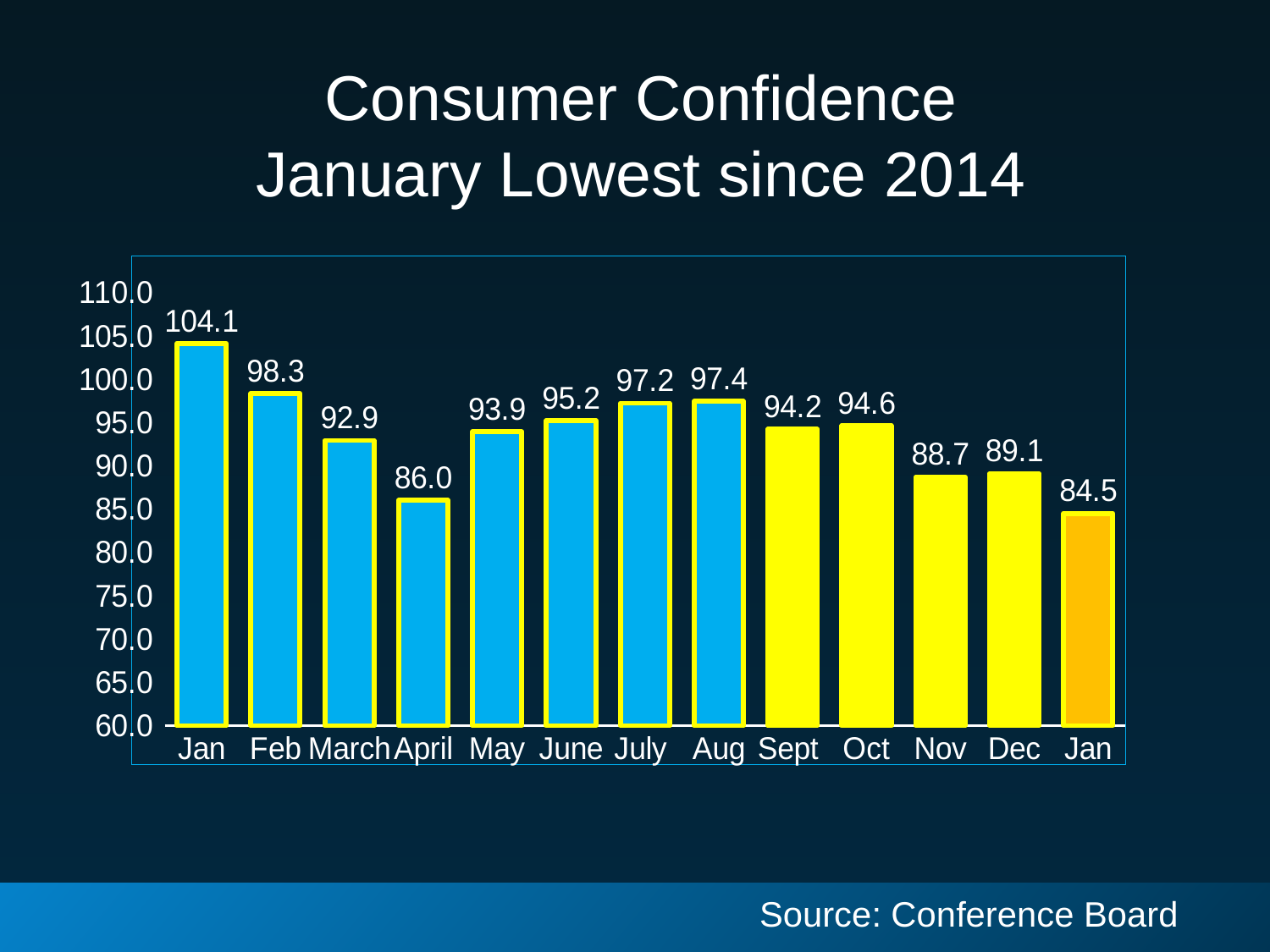
Which month has the lowest consumer confidence value? Jan (last bar, 84.5) What is the difference between the Dec value and the final Jan value? 4.6 What is the consumer confidence value for April? 86.0 What is the consumer confidence value for Oct? 94.6 How many bars are shown in the chart? 13 What is the difference between the first Jan value and the Feb value? 5.8 Is the value for Nov greater or less than 90.0? less What kind of chart is shown on the slide? bar chart What is the source cited for the chart data? Conference Board Which month has the highest consumer confidence value? Jan (first bar, 104.1) What is the value for the final Jan bar on the right of the chart? 84.5 Which is larger, the value for July or the value for Aug? Aug